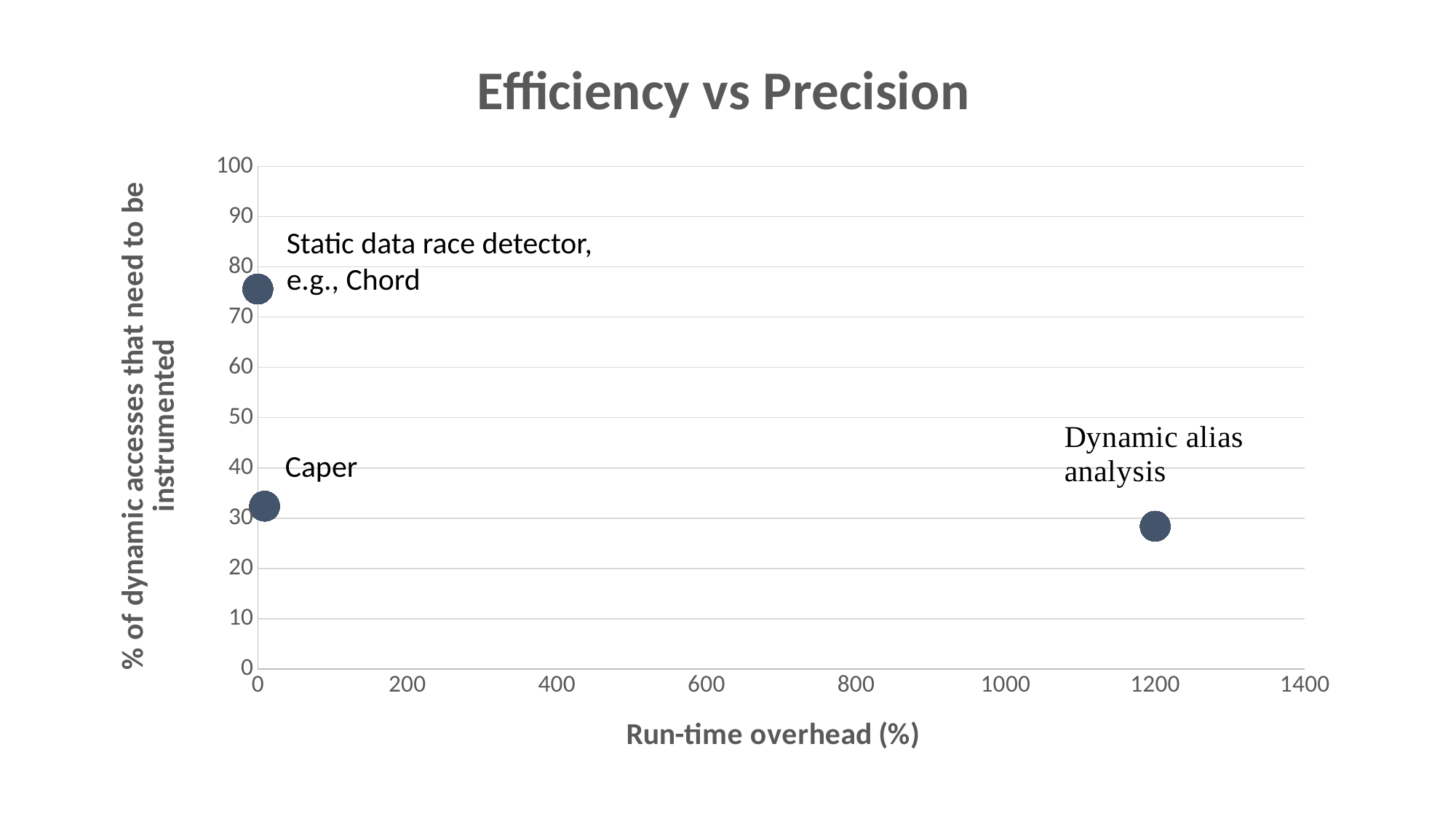
What is the label of the x axis? Run-time overhead (%) Is the run-time overhead for Caper greater or less than 200? less How many data points are plotted on the chart? 3 What is the title of the chart? Efficiency vs Precision Which has a higher percentage of dynamic accesses that need to be instrumented, Caper or the static data race detector (Chord)? Static data race detector, e.g., Chord Is the percentage of dynamic accesses that need to be instrumented for the static data race detector (Chord) greater or less than 70? greater Is the run-time overhead for Dynamic alias analysis greater or less than 1000? greater What kind of chart is shown on the slide? scatter chart Which point has the highest percentage of dynamic accesses that need to be instrumented? Static data race detector, e.g., Chord Which point has the highest run-time overhead? Dynamic alias analysis